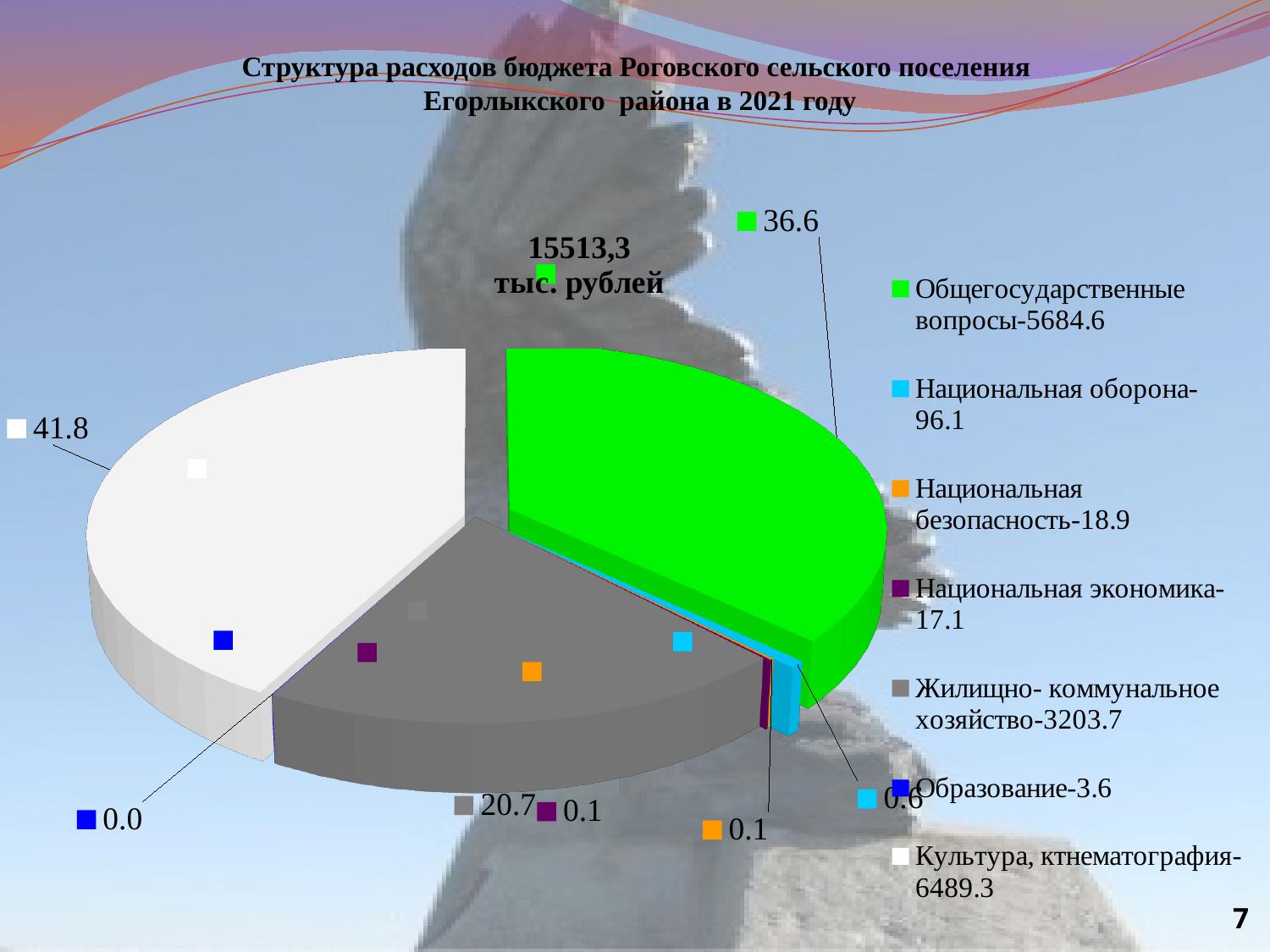
What kind of chart is shown on the slide? pie chart Which category has the largest slice of the pie? Культура, ктнематография How many entries does the legend list? 7 What is the data label on the white slice (Культура, ктнематография)? 41.8 What total amount is printed above the pie chart? 15513,3 тыс. рублей According to the legend, what is the amount for Жилищно-коммунальное хозяйство? 3203.7 What is the data label on the dark blue slice (Образование)? 0.0 What is the difference between the data labels of the white slice (41.8) and the green slice (36.6)? 5.2 Which is larger, the slice for Общегосударственные вопросы or the slice for Жилищно-коммунальное хозяйство? Общегосударственные вопросы What is the data label on the light blue slice (Национальная оборона)? 0.6 What is the data label on the green slice (Общегосударственные вопросы)? 36.6 What is the data label on the grey slice (Жилищно-коммунальное хозяйство)? 20.7